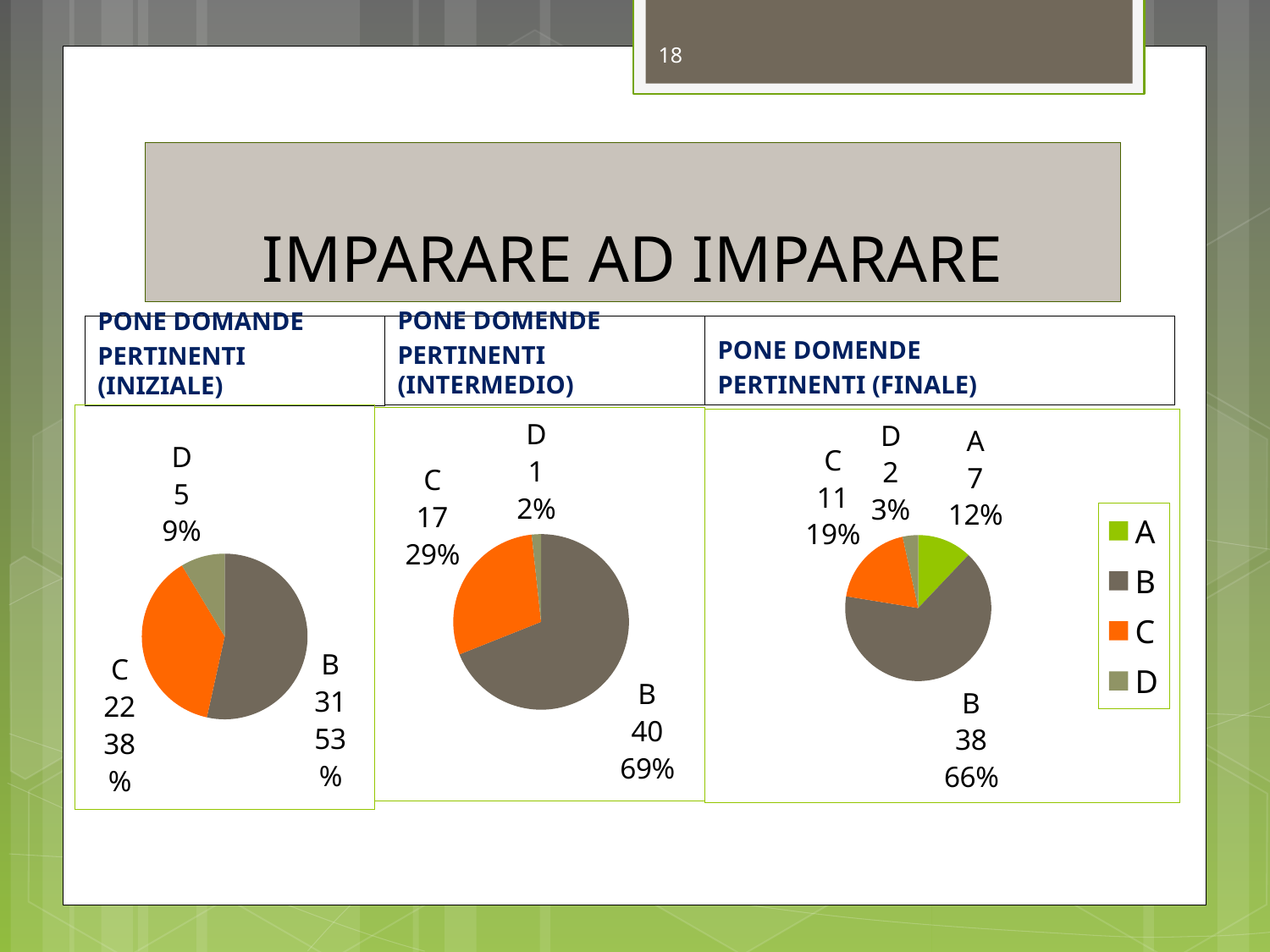
How many slices does the PONE DOMENDE PERTINENTI (FINALE) chart have? 4 In the PONE DOMENDE PERTINENTI (INTERMEDIO) chart, what is the difference between the values for B and C? 23 In the PONE DOMENDE PERTINENTI (FINALE) chart, which category has the largest slice? B In the PONE DOMANDE PERTINENTI (INIZIALE) chart, what percentage share does category C have? 38% In the PONE DOMENDE PERTINENTI (INTERMEDIO) chart, what value is shown for category C? 17 In the PONE DOMENDE PERTINENTI (FINALE) chart, what value is shown for category A? 7 How many entries does the legend on the right of the slide list? 4 What type of chart is used for PONE DOMANDE PERTINENTI (INIZIALE)? Pie chart In the PONE DOMANDE PERTINENTI (INIZIALE) chart, what value is shown for category B? 31 In the PONE DOMENDE PERTINENTI (INTERMEDIO) chart, what percentage share does category B have? 69% In the PONE DOMANDE PERTINENTI (INIZIALE) chart, which category has the smallest slice? D In the PONE DOMENDE PERTINENTI (FINALE) chart, which is larger, the value for C or the value for D? C